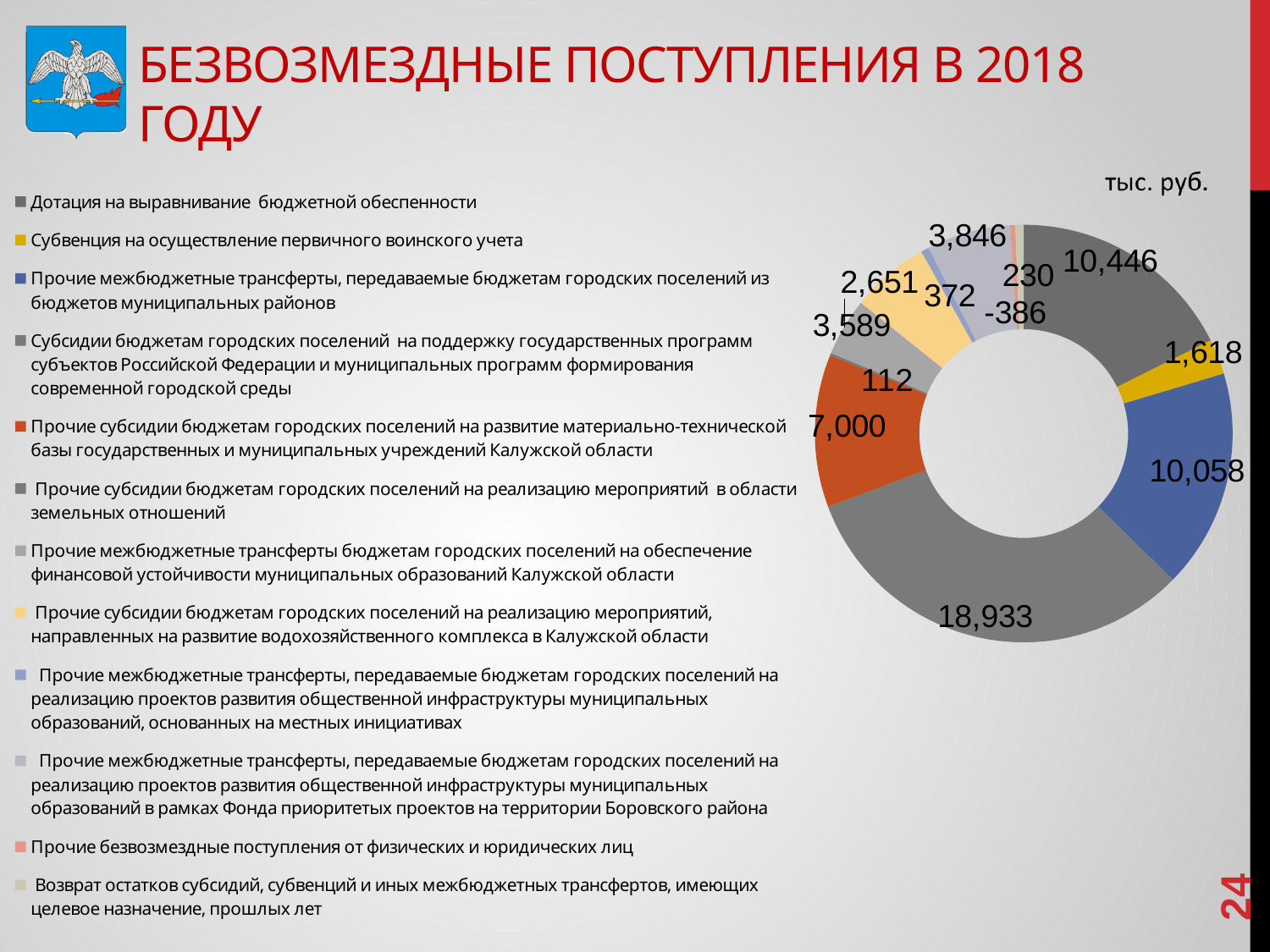
What type of chart is shown on the slide? Doughnut (pie) chart What is the difference between the values 10,446 and 10,058 on the chart? 388 How many categories does the legend list? 12 In what units are the chart values given? тыс. руб. What is the title of the slide containing the chart? БЕЗВОЗМЕЗДНЫЕ ПОСТУПЛЕНИЯ В 2018 ГОДУ Which is larger: the slice labelled 7,000 or the slice labelled 3,846? 7,000 What is the value for 'Прочие субсидии бюджетам городских поселений на развитие материально-технической базы государственных и муниципальных учреждений Калужской области' (orange slice)? 7,000 What is the value for 'Прочие межбюджетные трансферты, передаваемые бюджетам городских поселений из бюджетов муниципальных районов' (blue slice)? 10,058 What is the largest value shown on the chart? 18,933 What is the value for 'Субвенция на осуществление первичного воинского учета' (yellow slice)? 1,618 What is the smallest value shown on the chart? -386 What is the value for 'Дотация на выравнивание бюджетной обеспеченности'? 10,446